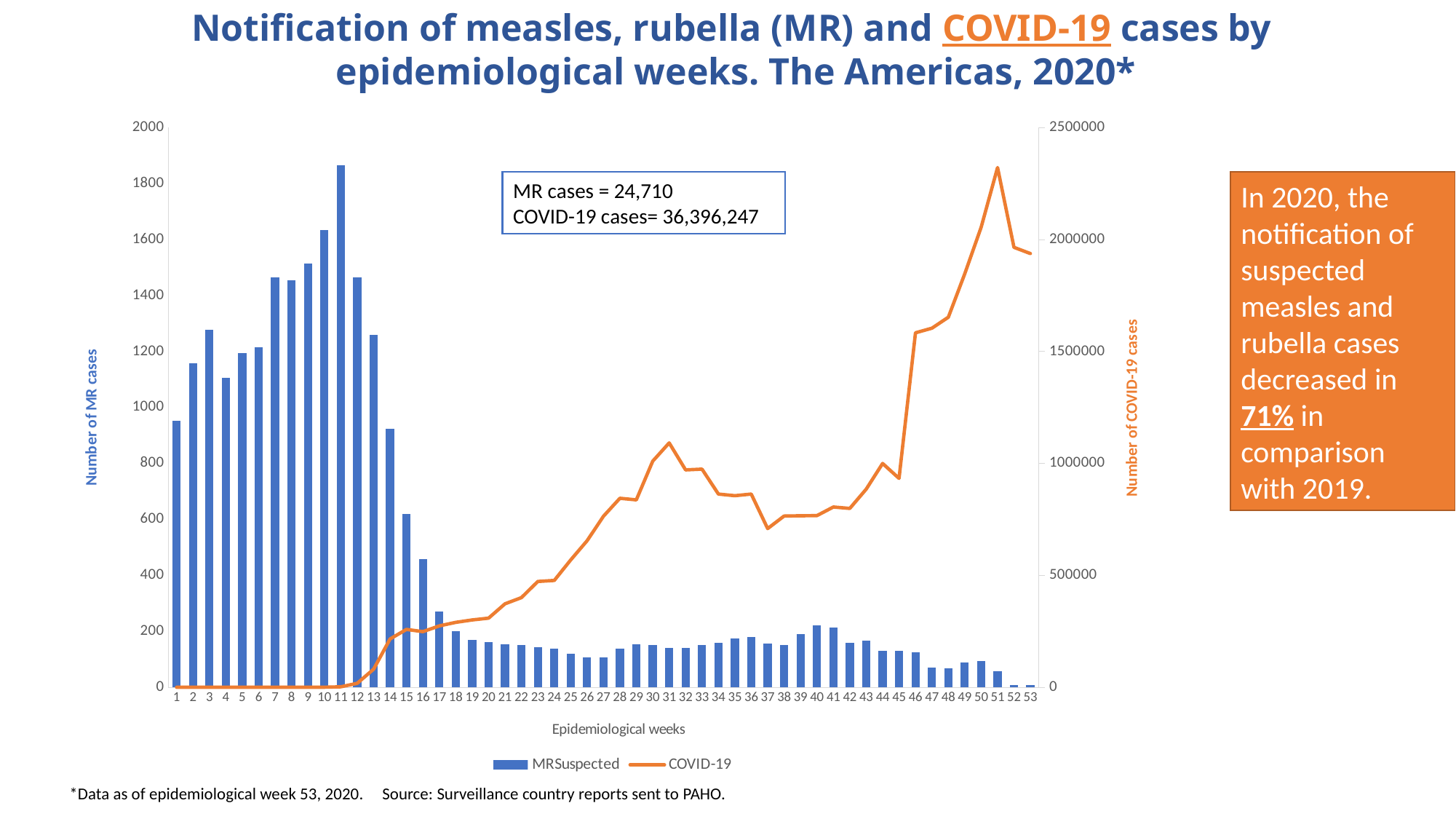
What kind of chart is shown on the slide? A combined bar and line chart How many epidemiological weeks are shown on the x axis? 53 What are the two series named in the legend? MRSuspected and COVID-19 Is the number of COVID-19 cases in week 51 greater or less than 2000000? greater According to the text box on the chart, what is the total number of COVID-19 cases? 36,396,247 In which epidemiological week does the COVID-19 line reach its peak? Week 51 Which week has more suspected MR cases, week 1 or week 11? Week 11 Is the number of suspected MR cases in week 11 greater or less than 1600? greater In which epidemiological week is the number of suspected MR cases highest? Week 11 How many series does the legend list? 2 Is the number of suspected MR cases in week 1 greater or less than 1000? less